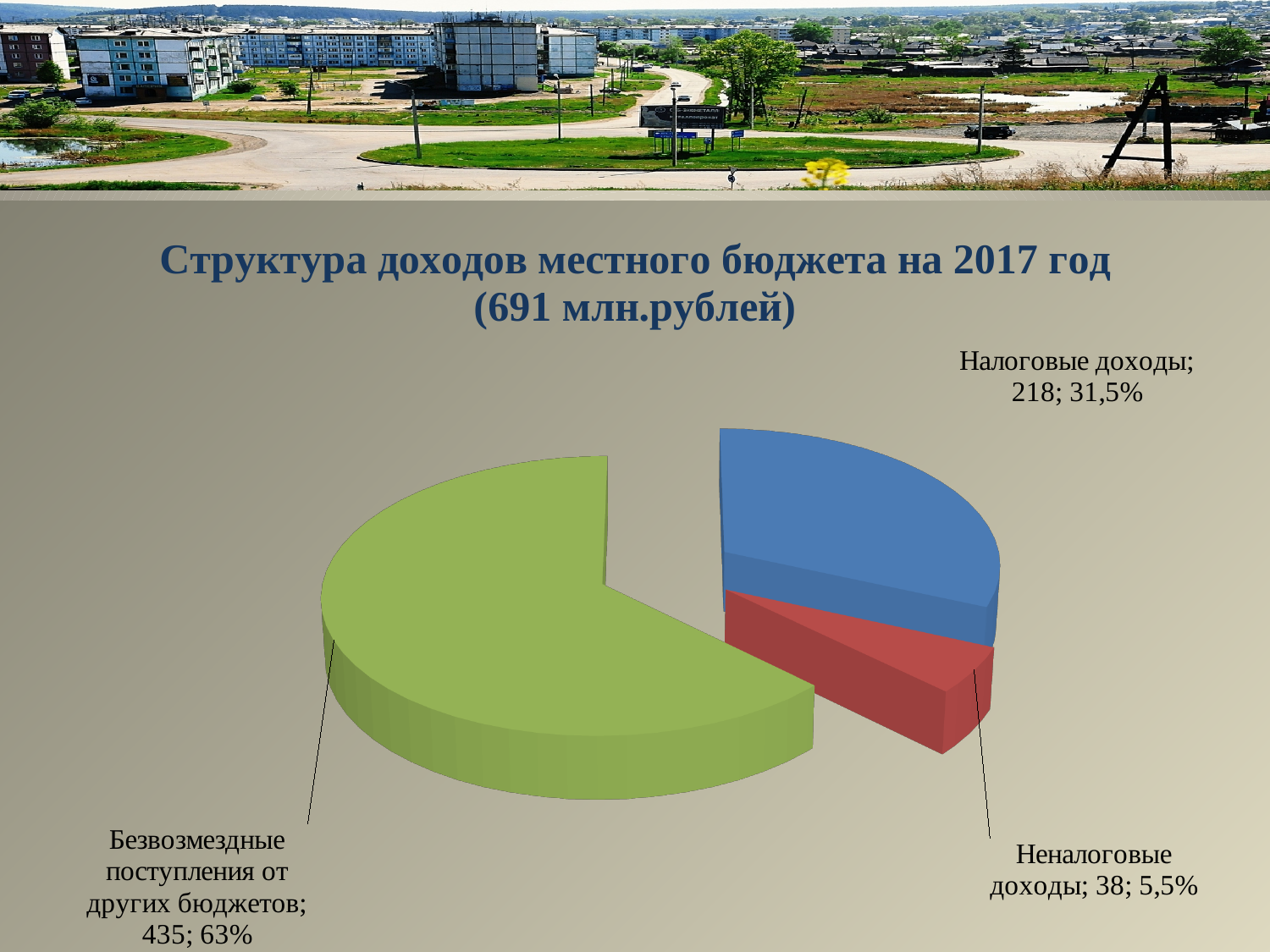
What is the difference between the values for Безвозмездные поступления от других бюджетов and Налоговые доходы? 217 Which is larger, Налоговые доходы or Неналоговые доходы? Налоговые доходы Which category has the largest slice? Безвозмездные поступления от других бюджетов What share of the pie does Безвозмездные поступления от других бюджетов represent? 63% What type of chart is shown on the slide? Pie chart What is the value for Неналоговые доходы? 38 What is the value for Безвозмездные поступления от других бюджетов? 435 How many slices does the pie chart have? 3 Which category has the smallest slice? Неналоговые доходы What is the title of the chart? Структура доходов местного бюджета на 2017 год (691 млн.рублей) What share of the pie does Налоговые доходы represent? 31,5% What is the value for Налоговые доходы? 218